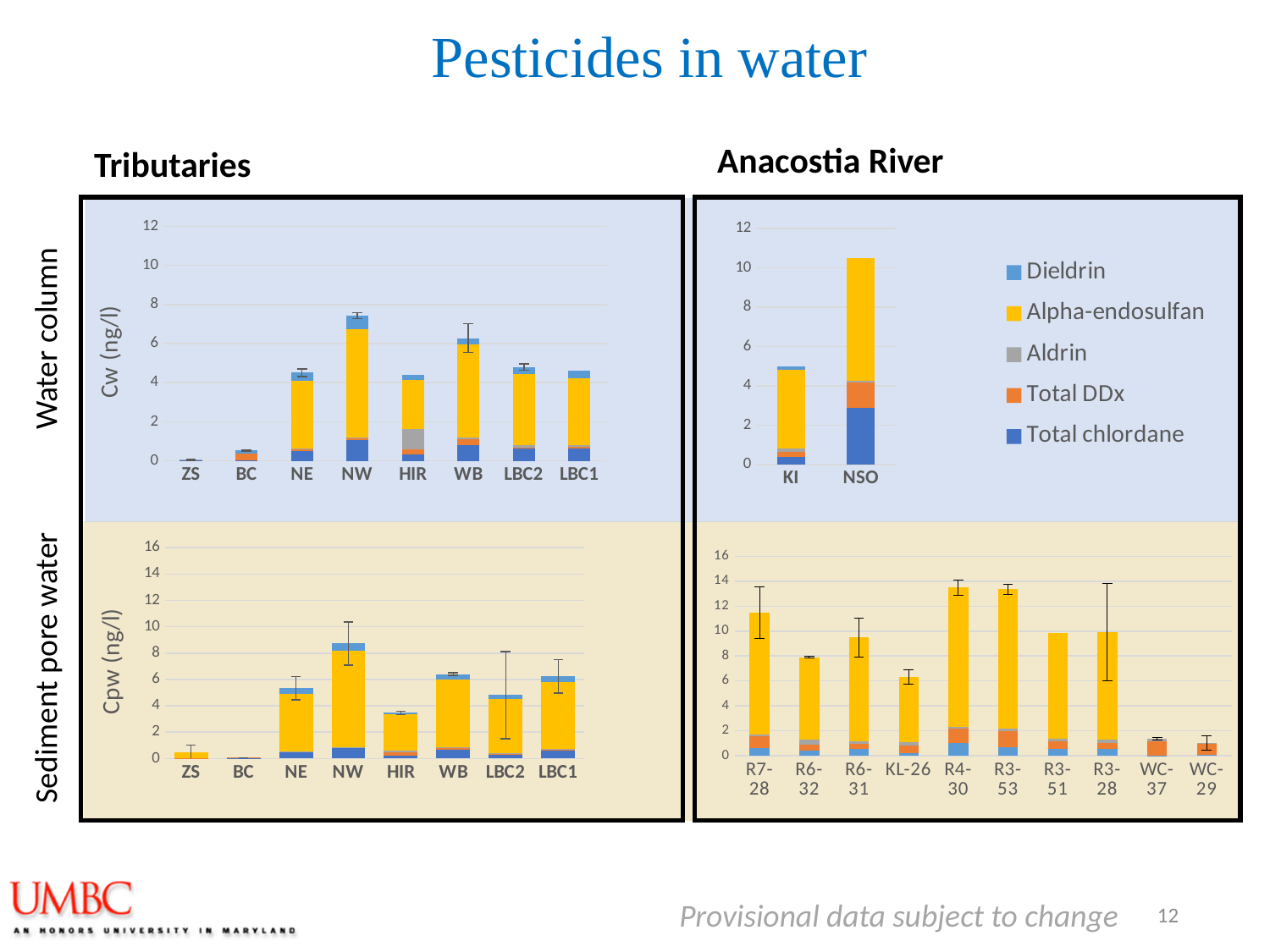
How many series does the legend list? 5 In the Tributaries water column chart (top-left), which category has the smallest stacked bar? ZS How many categories are shown on the x axis of the Anacostia River water column chart (top-right)? 2 In the Anacostia River water column chart (top-right), which bar is taller, KI or NSO? NSO What kind of chart is the Tributaries water column chart (top-left)? bar chart How many categories are shown on the x axis of the Anacostia River sediment pore water chart (bottom-right)? 10 In the Tributaries sediment pore water chart (bottom-left), which category has the tallest stacked bar? NW In the Anacostia River sediment pore water chart (bottom-right), is the total value for KL-26 greater or less than 8? less In the Anacostia River water column chart (top-right), is the total value for NSO greater or less than 8? greater What is the y-axis label of the Tributaries water column chart (top-left)? Cw (ng/l) How many categories are shown on the x axis of the Tributaries water column chart (top-left)? 8 In the Tributaries water column chart (top-left), which category has the tallest stacked bar? NW